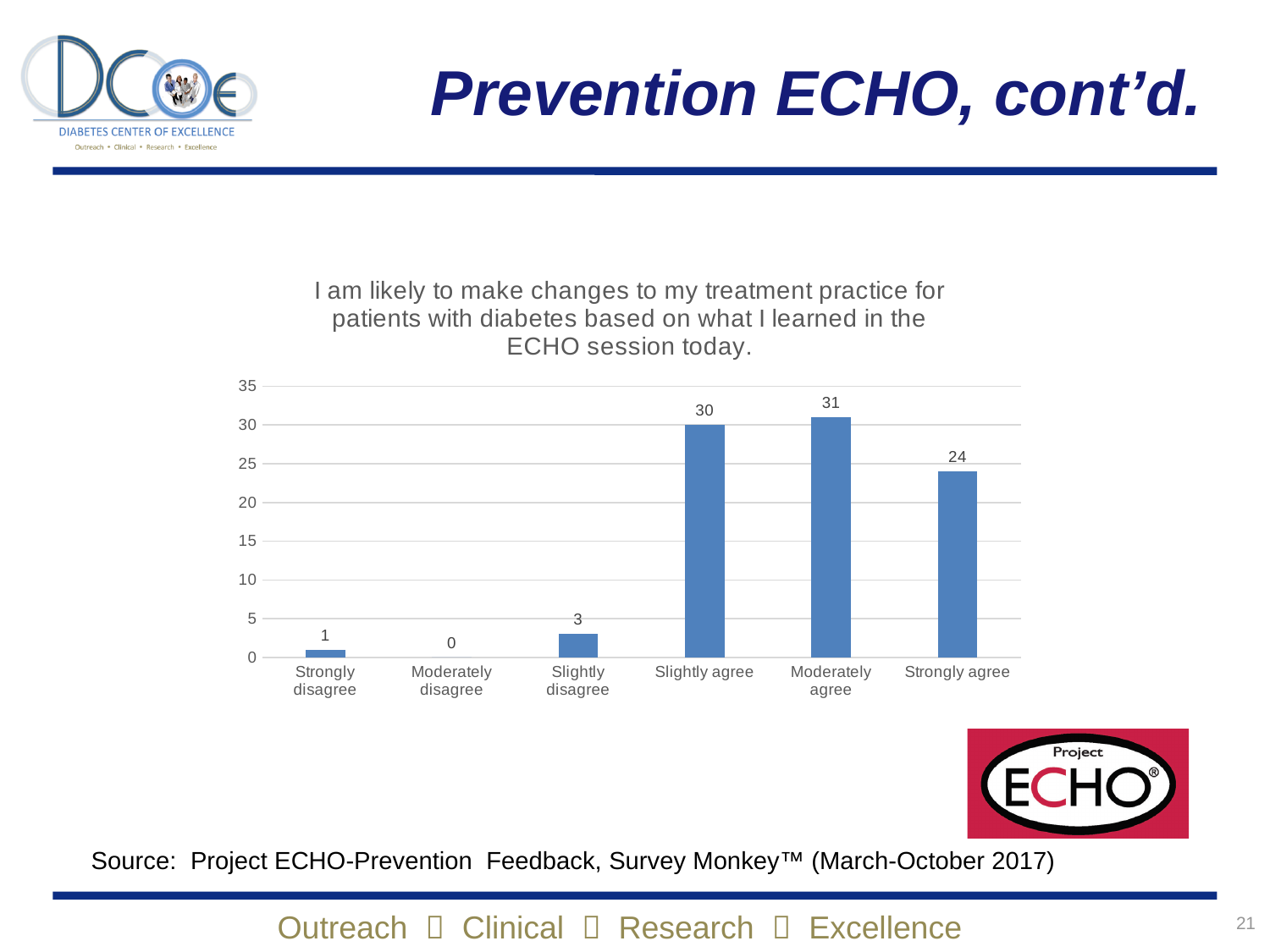
What is the title of the chart? I am likely to make changes to my treatment practice for patients with diabetes based on what I learned in the ECHO session today. Which is larger, the value for Slightly agree or the value for Strongly agree? Slightly agree Is the value for Strongly agree greater or less than 20? greater What is the value for Moderately agree? 31 What is the difference between the values for Slightly agree and Strongly agree? 6 What is the value for Moderately disagree? 0 Which category has the highest value? Moderately agree How many categories are shown on the x axis? 6 Which category has the lowest value? Moderately disagree What kind of chart is shown on the slide? bar chart What is the value for Slightly disagree? 3 What is the value for Strongly agree? 24